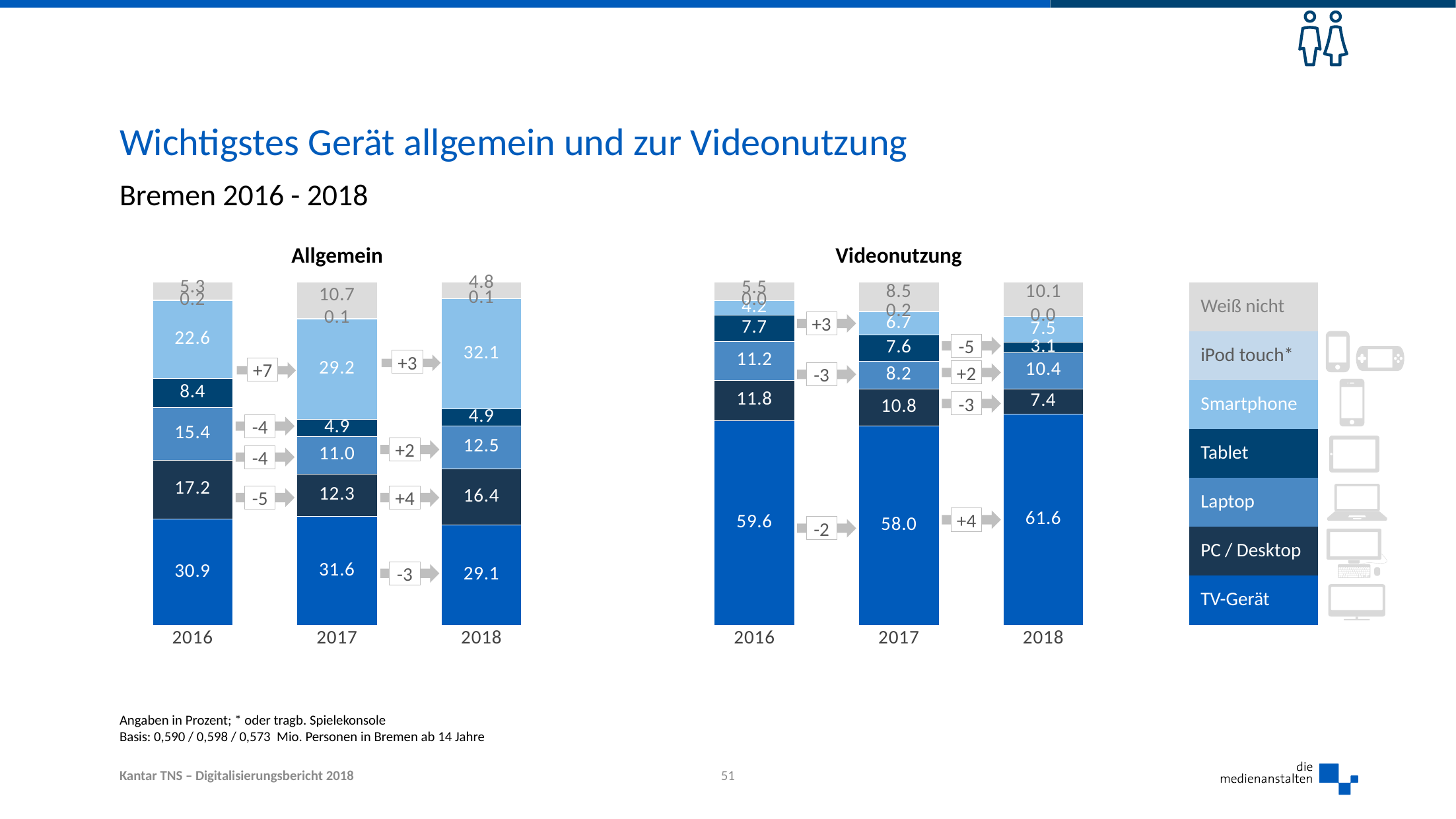
How many years are shown on the x axis of the Videonutzung chart? 3 In the Allgemein chart, what is the difference between the Smartphone values in 2016 and 2018? 9.5 How many device categories does the legend list? 7 In the Allgemein chart, what is the value for TV-Gerät in 2017? 31.6 In the Allgemein chart, does the TV-Gerät value rise or fall from 2017 to 2018? fall What kind of chart is the Allgemein chart? stacked bar chart In the Videonutzung chart, what is the value for Laptop in 2016? 11.2 In the Allgemein chart, which device has the highest value in 2018? Smartphone In the Allgemein chart, what is the value for Smartphone in 2018? 32.1 In the Videonutzung chart, which device has the lowest value in 2017? iPod touch* In the Videonutzung chart, which is larger in 2018: Laptop or PC / Desktop? Laptop In the Videonutzung chart, what is the value for TV-Gerät in 2018? 61.6